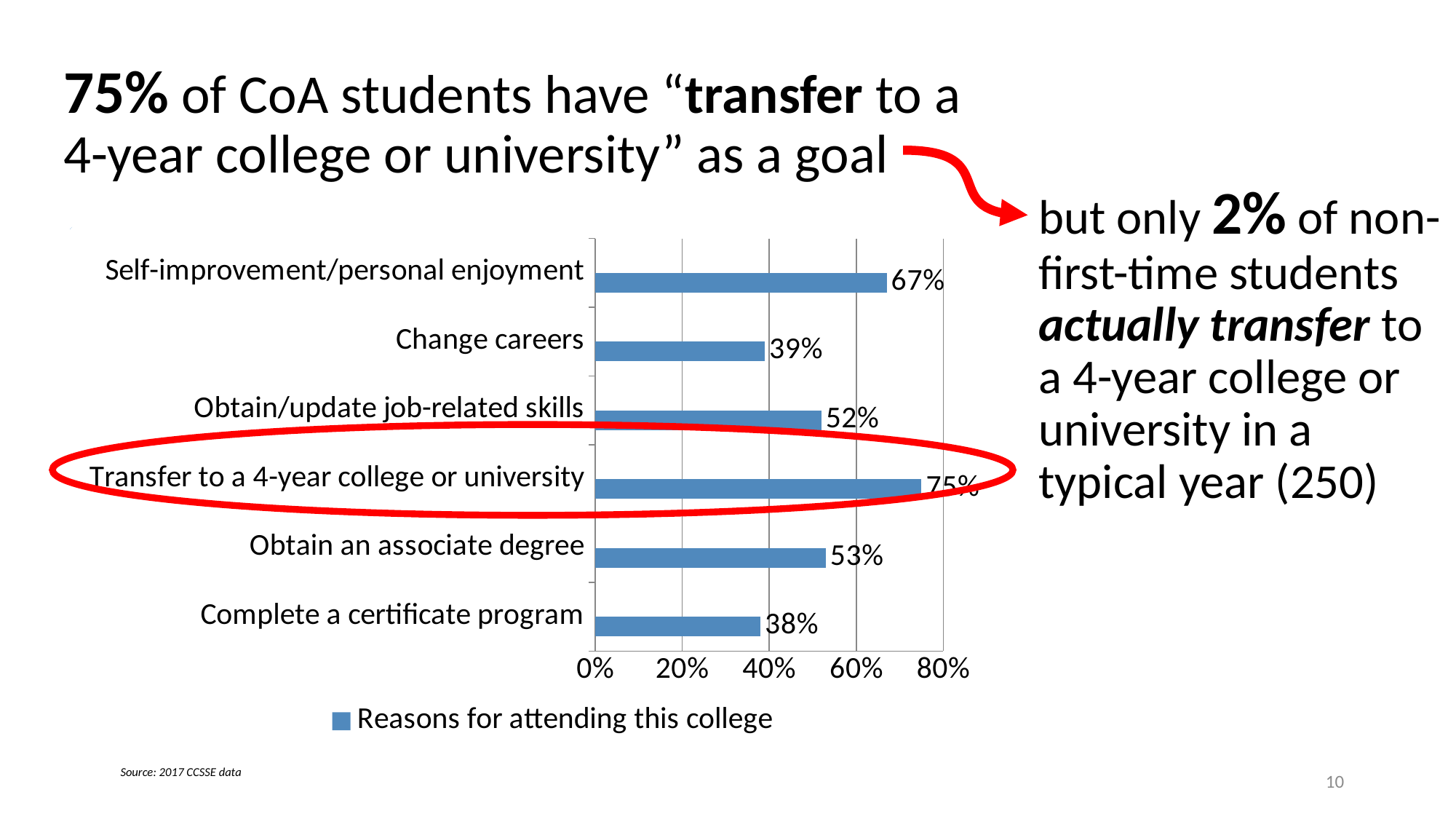
What is the difference between the values for "Transfer to a 4-year college or university" and "Self-improvement/personal enjoyment"? 8% What kind of chart is shown on the slide? Bar chart How many reasons for attending are shown in the chart? 6 Which reason for attending has the lowest value? Complete a certificate program Which is larger: the value for "Obtain an associate degree" or "Change careers"? Obtain an associate degree What percentage of students cite "Self-improvement/personal enjoyment" as a reason for attending this college? 67% What is the value for "Complete a certificate program"? 38% How many series does the legend list? 1 What is the legend entry for the series in the chart? Reasons for attending this college Which reason for attending has the highest value? Transfer to a 4-year college or university Is the value for "Obtain/update job-related skills" greater or less than 40%? greater What is the value for "Change careers"? 39%